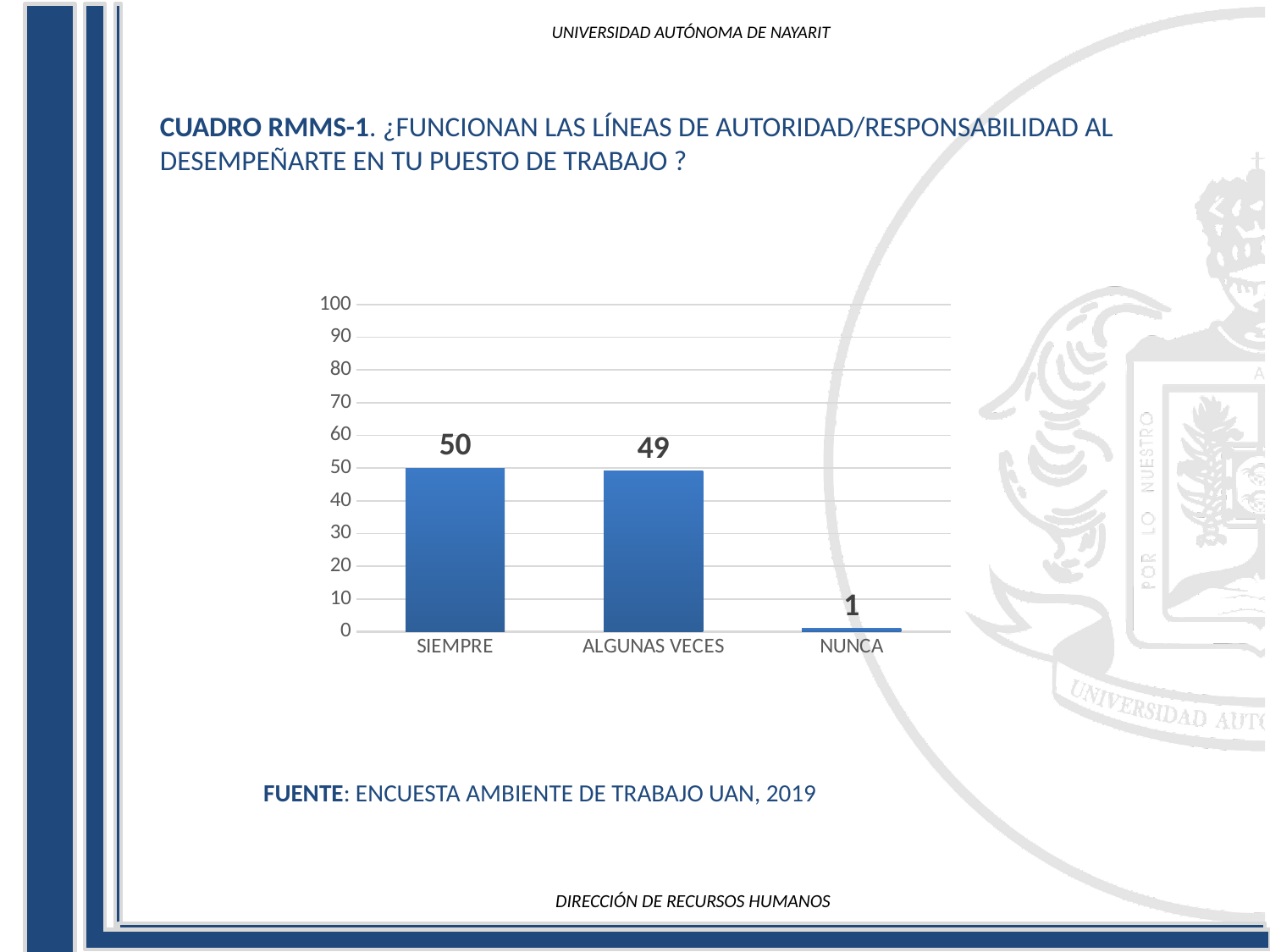
What is the value for ALGUNAS VECES? 49 What is the source cited below the chart? ENCUESTA AMBIENTE DE TRABAJO UAN, 2019 Which category has the lowest value? NUNCA Which category has the highest value? SIEMPRE What kind of chart is shown on the slide? bar chart What is the value for NUNCA? 1 Which is larger, the value for ALGUNAS VECES or the value for NUNCA? ALGUNAS VECES How many categories are shown on the x axis? 3 Is the value for ALGUNAS VECES greater or less than 30? greater What is the value for SIEMPRE? 50 What is the difference between the values for SIEMPRE and NUNCA? 49 What is the difference between the values for SIEMPRE and ALGUNAS VECES? 1